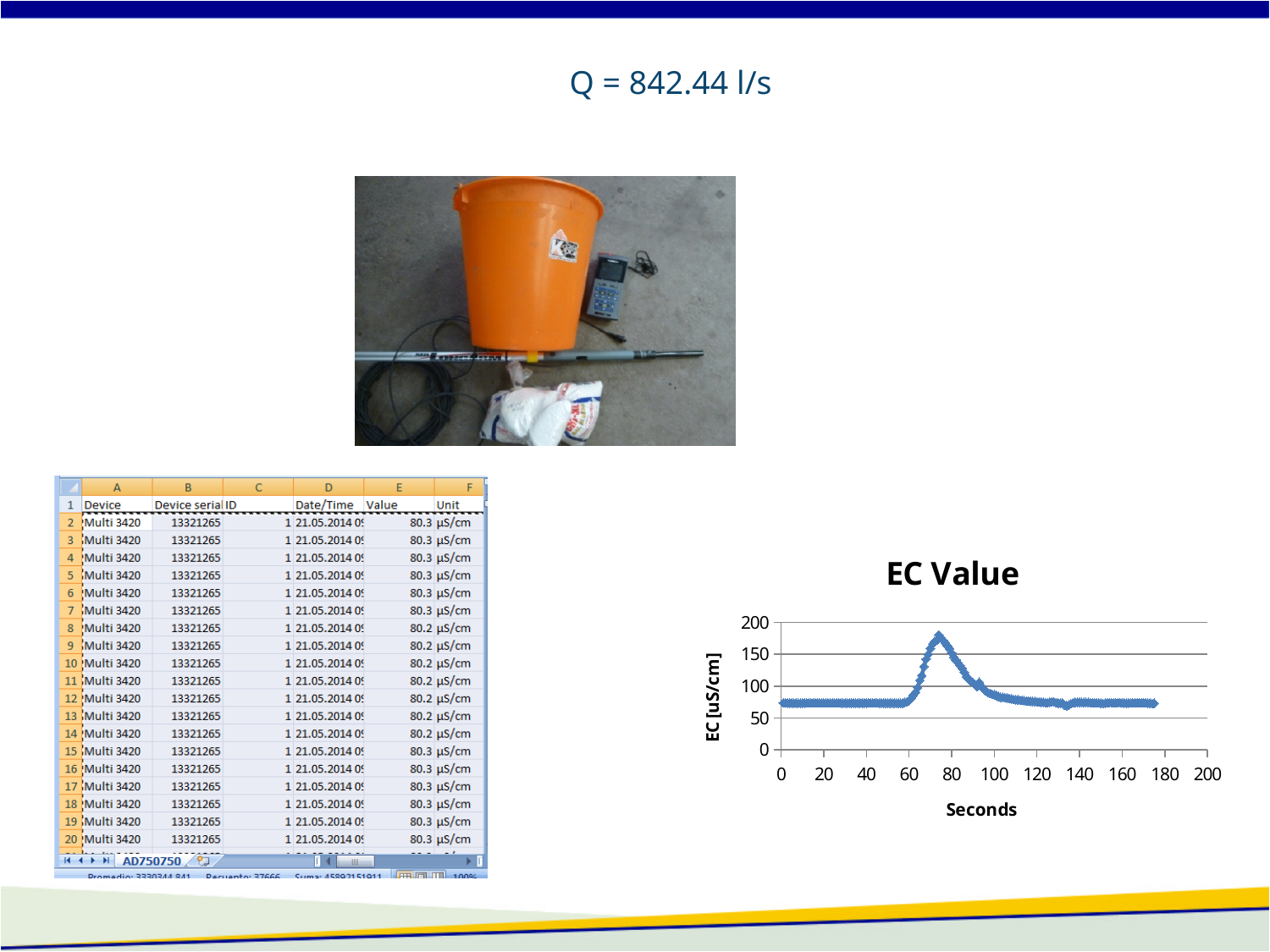
What is the highest value shown on the y axis of the EC Value chart? 200 In the EC Value chart, which is larger: the value at 80 seconds or the value at 20 seconds? the value at 80 seconds What kind of chart is the EC Value chart? scatter (line) chart with markers Is the value at 40 seconds in the EC Value chart greater or less than 50? greater Is the peak value in the EC Value chart greater or less than 150? greater In the EC Value chart, do the values rise or fall between 80 and 100 seconds? fall What is the label of the x axis of the EC Value chart? Seconds In the EC Value chart, do the values rise or fall between 60 and 75 seconds? rise Is the value at 20 seconds in the EC Value chart greater or less than 100? less What is the title of the chart on the slide? EC Value In the EC Value chart, which is larger: the value at 100 seconds or the value at 140 seconds? the value at 100 seconds